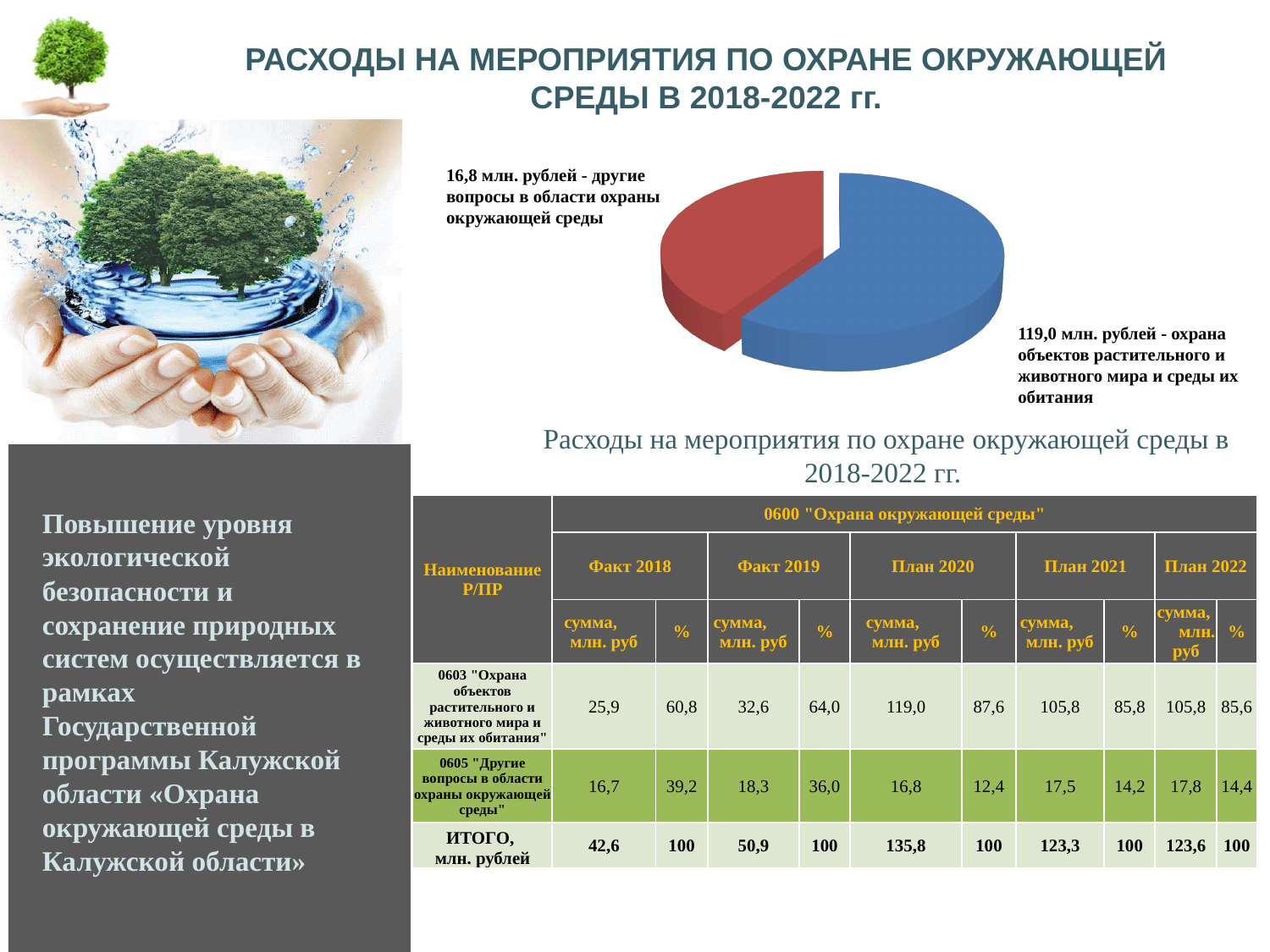
What colour is the pie slice for 'охрана объектов растительного и животного мира и среды их обитания'? blue What is the total of the two values shown in the pie chart? 135,8 млн. рублей What is the value of the pie slice for 'другие вопросы в области охраны окружающей среды'? 16,8 млн. рублей What colour is the pie slice for 'другие вопросы в области охраны окружающей среды'? red What is the difference between the two pie slice values, 119,0 and 16,8 million rubles? 102,2 млн. рублей How many slices does the pie chart have? 2 Which slice of the pie chart is the smallest? другие вопросы в области охраны окружающей среды Which slice of the pie chart is the largest? охрана объектов растительного и животного мира и среды их обитания What kind of chart is shown on the slide? pie chart What is the value of the pie slice for 'охрана объектов растительного и животного мира и среды их обитания'? 119,0 млн. рублей Which is larger in the pie chart: the slice for 'другие вопросы' or the slice for 'охрана объектов растительного и животного мира'? охрана объектов растительного и животного мира и среды их обитания